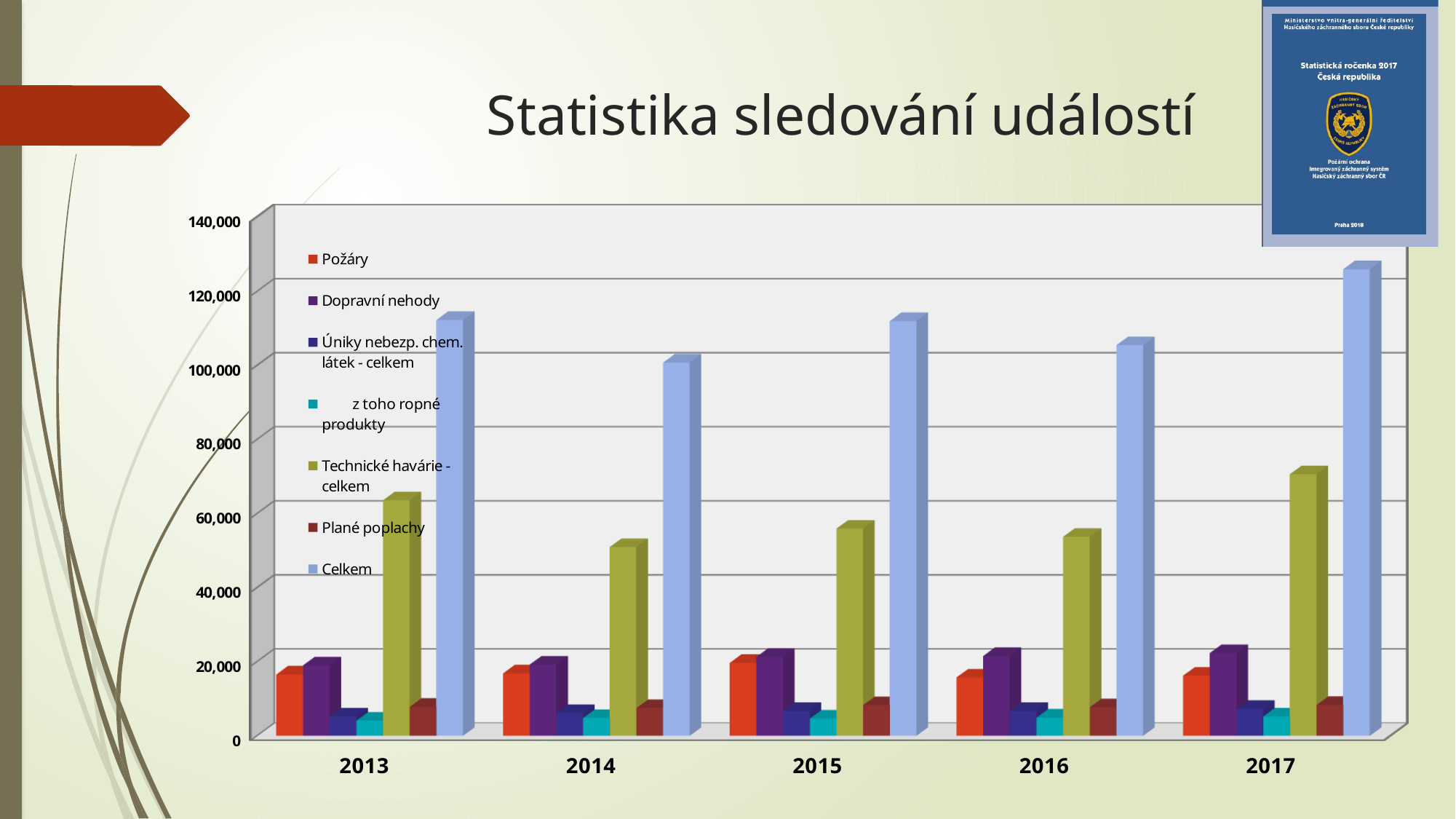
Is the Celkem value for 2017 greater or less than 120,000? greater Which is larger, the Celkem value for 2017 or for 2014? 2017 What kind of chart is shown on the slide? bar chart How many years are shown on the x axis of the chart? 5 How many series does the chart legend list? 7 In which year is the Technické havárie - celkem bar the highest? 2017 What is the title of the slide containing the chart? Statistika sledování událostí Is the Technické havárie - celkem value for 2013 greater or less than 60,000? greater Is the Celkem value for 2014 greater or less than 120,000? less In 2017, which is larger, Dopravní nehody or Požáry? Dopravní nehody In which year is the Celkem bar the highest? 2017